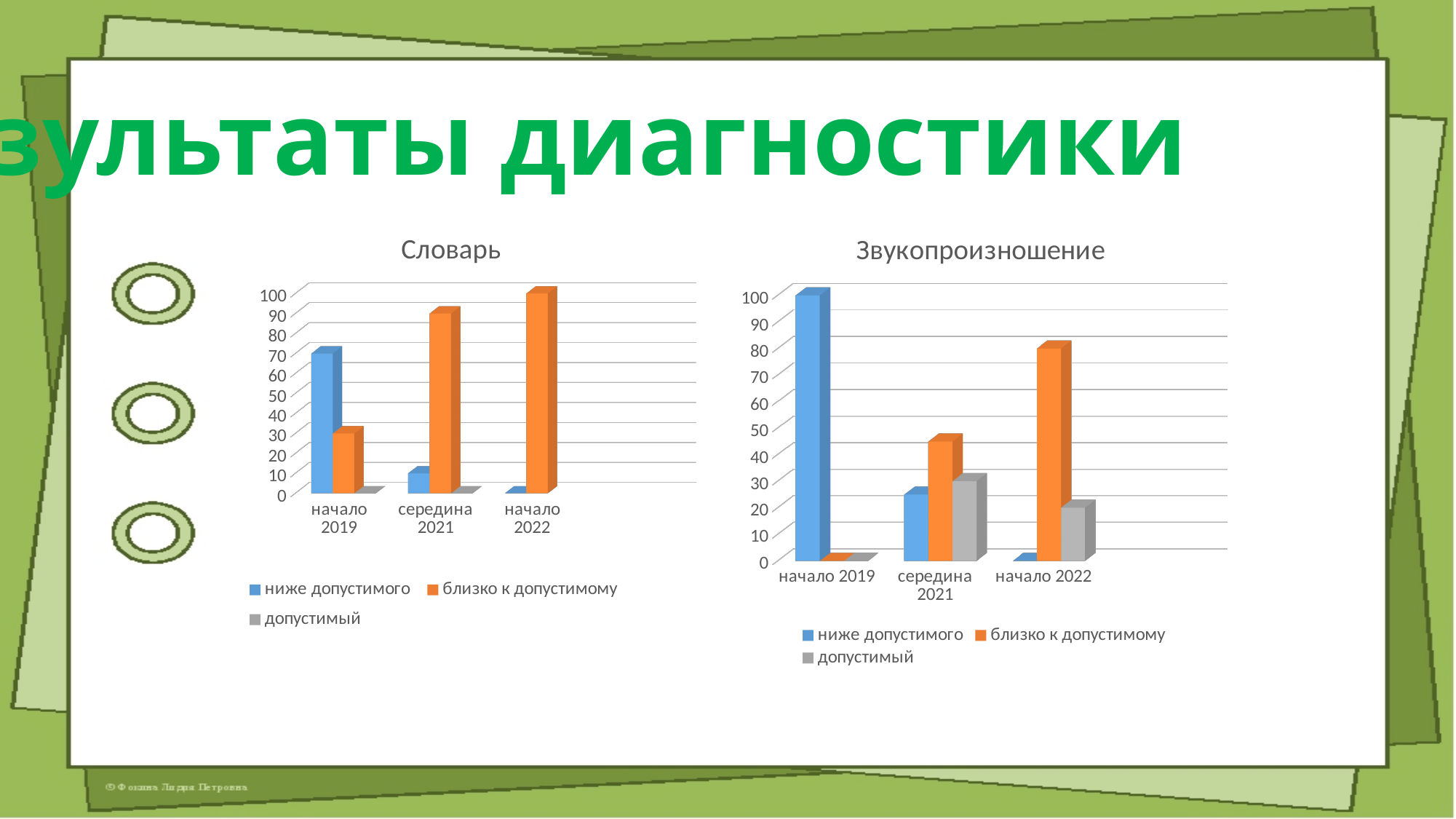
In the 'Звукопроизношение' chart, does the 'ниже допустимого' series rise or fall across the x axis? fall In the 'Словарь' chart, is the value for 'близко к допустимому' at 'начало 2022' greater or less than 80? greater In the 'Словарь' chart, does the 'близко к допустимому' series rise or fall from 'начало 2019' to 'начало 2022'? rise In the 'Словарь' chart, is the value for 'ниже допустимого' at 'середина 2021' greater or less than 20? less In the 'Звукопроизношение' chart, which is larger at 'середина 2021': 'близко к допустимому' or 'ниже допустимого'? близко к допустимому In the 'Словарь' chart, which category has the highest value for 'ниже допустимого'? начало 2019 What colour represents the 'допустимый' series in the 'Словарь' chart? gray What type of chart is the 'Словарь' chart? bar chart How many series does the legend of the 'Звукопроизношение' chart list? 3 How many categories are shown on the x axis of the 'Словарь' chart? 3 In the 'Звукопроизношение' chart, is the value for 'ниже допустимого' at 'начало 2019' greater or less than 90? greater In the 'Звукопроизношение' chart, which category has the highest value for 'близко к допустимому'? начало 2022